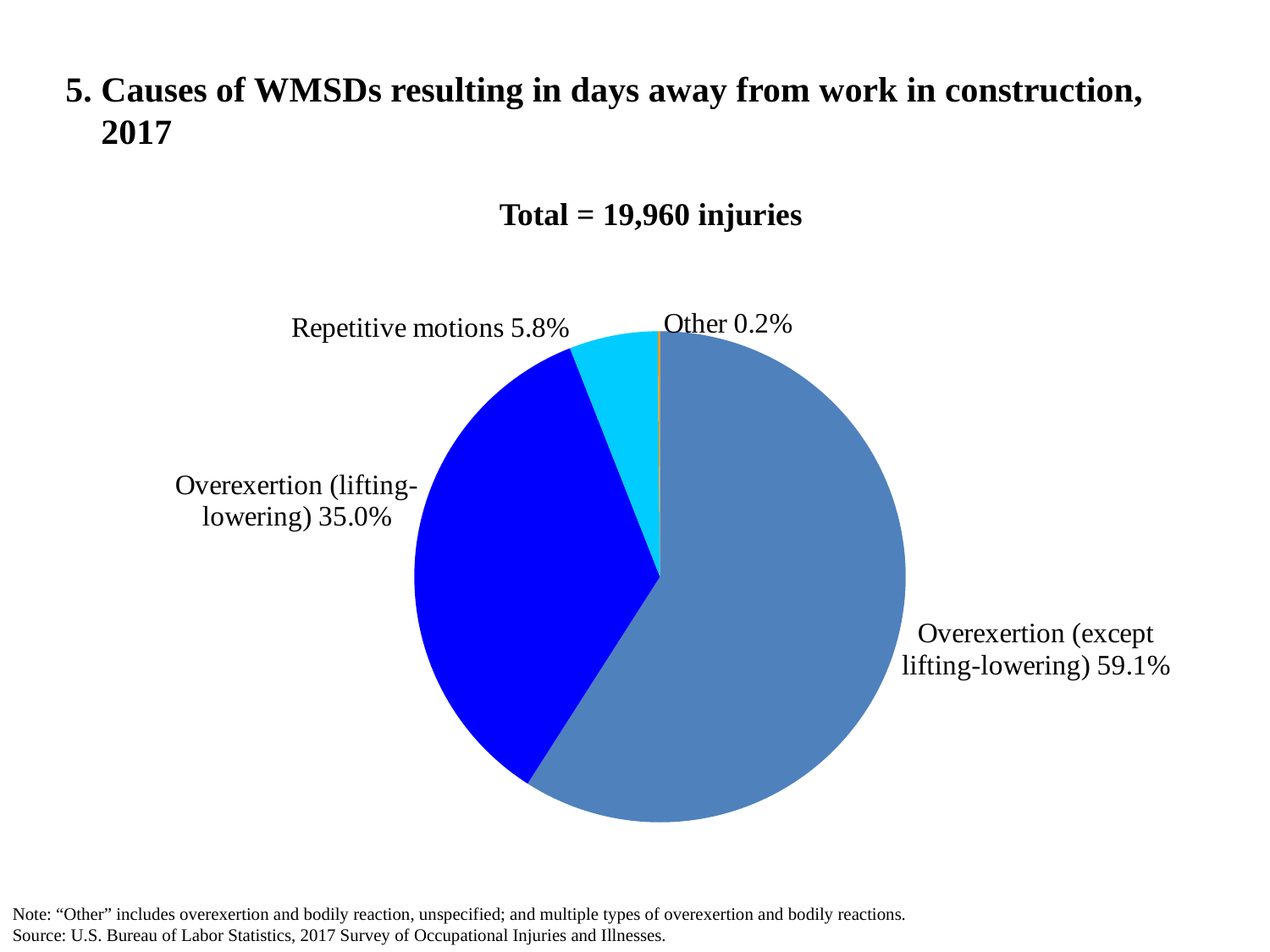
Which cause accounts for the largest share of injuries? Overexertion (except lifting-lowering) How many slices does the pie chart have? 4 What type of chart is shown on the slide? Pie chart Which cause accounts for the smallest share of injuries? Other What share of injuries is attributed to Repetitive motions? 5.8% What share of injuries is attributed to Overexertion (except lifting-lowering)? 59.1% Which is larger, the share for Repetitive motions or the share for Other? Repetitive motions What is the difference in percentage points between Overexertion (except lifting-lowering) and Overexertion (lifting-lowering)? 24.1 percentage points What is the source of the data shown in the chart? U.S. Bureau of Labor Statistics, 2017 Survey of Occupational Injuries and Illnesses What share of injuries is attributed to Other? 0.2% What is the total number of injuries stated on the slide? 19,960 injuries What share of injuries is attributed to Overexertion (lifting-lowering)? 35.0%